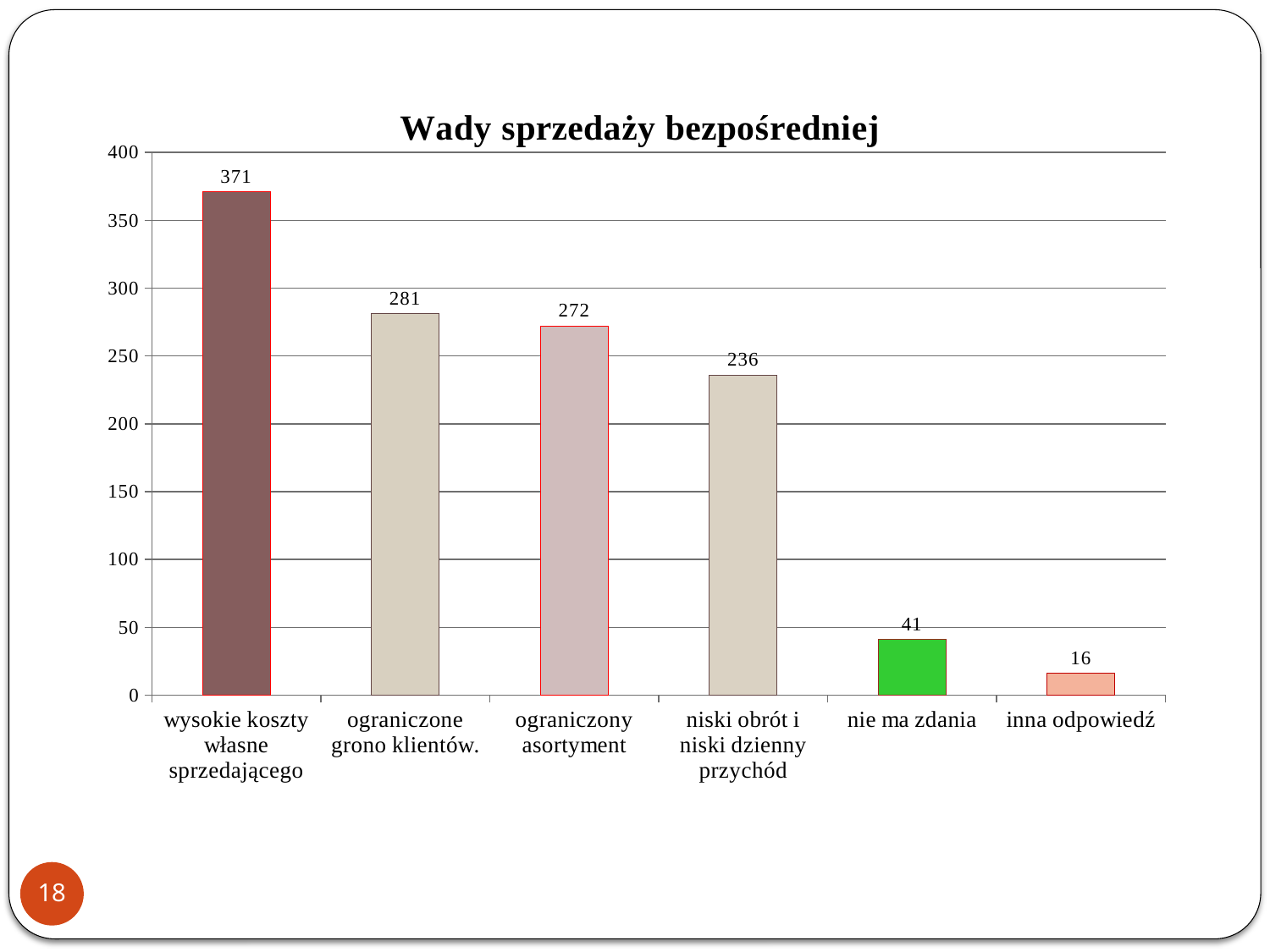
Is the value for "ograniczone grono klientów." greater or less than 250? greater What is the difference between the values for "wysokie koszty własne sprzedającego" and "inna odpowiedź"? 355 What is the title of the chart? Wady sprzedaży bezpośredniej What is the difference between the values for "ograniczone grono klientów." and "ograniczony asortyment"? 9 Which category has the highest value? wysokie koszty własne sprzedającego How many categories are shown on the chart? 6 Which category has the lowest value? inna odpowiedź What is the value for "wysokie koszty własne sprzedającego"? 371 What kind of chart is shown on the slide? bar chart Which is larger, the value for "ograniczony asortyment" or the value for "niski obrót i niski dzienny przychód"? ograniczony asortyment What is the value for "nie ma zdania"? 41 What is the value for "niski obrót i niski dzienny przychód"? 236